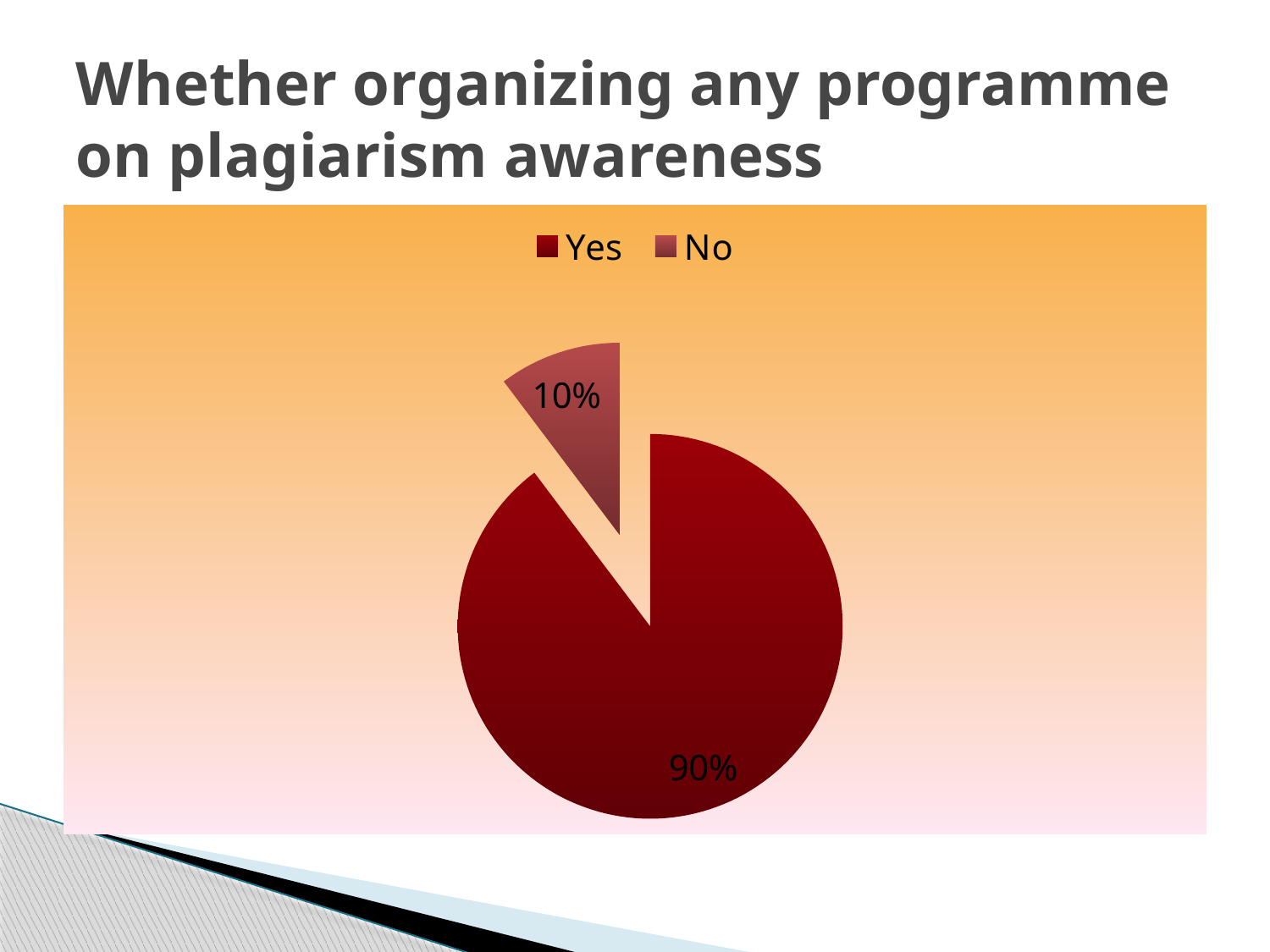
How many categories does the pie chart show? 2 Which is larger, the "Yes" slice or the "No" slice? Yes Which slice is pulled out (exploded) from the pie? No What is the title of the slide containing the chart? Whether organizing any programme on plagiarism awareness What kind of chart is shown on the slide? pie chart Which category has the largest slice of the pie? Yes Which category has the smallest slice of the pie? No What share of the pie does the "Yes" slice represent? 90% What share of the pie does the "No" slice represent? 10% How many entries does the legend list? 2 What is the difference in percentage points between the "Yes" and "No" slices? 80